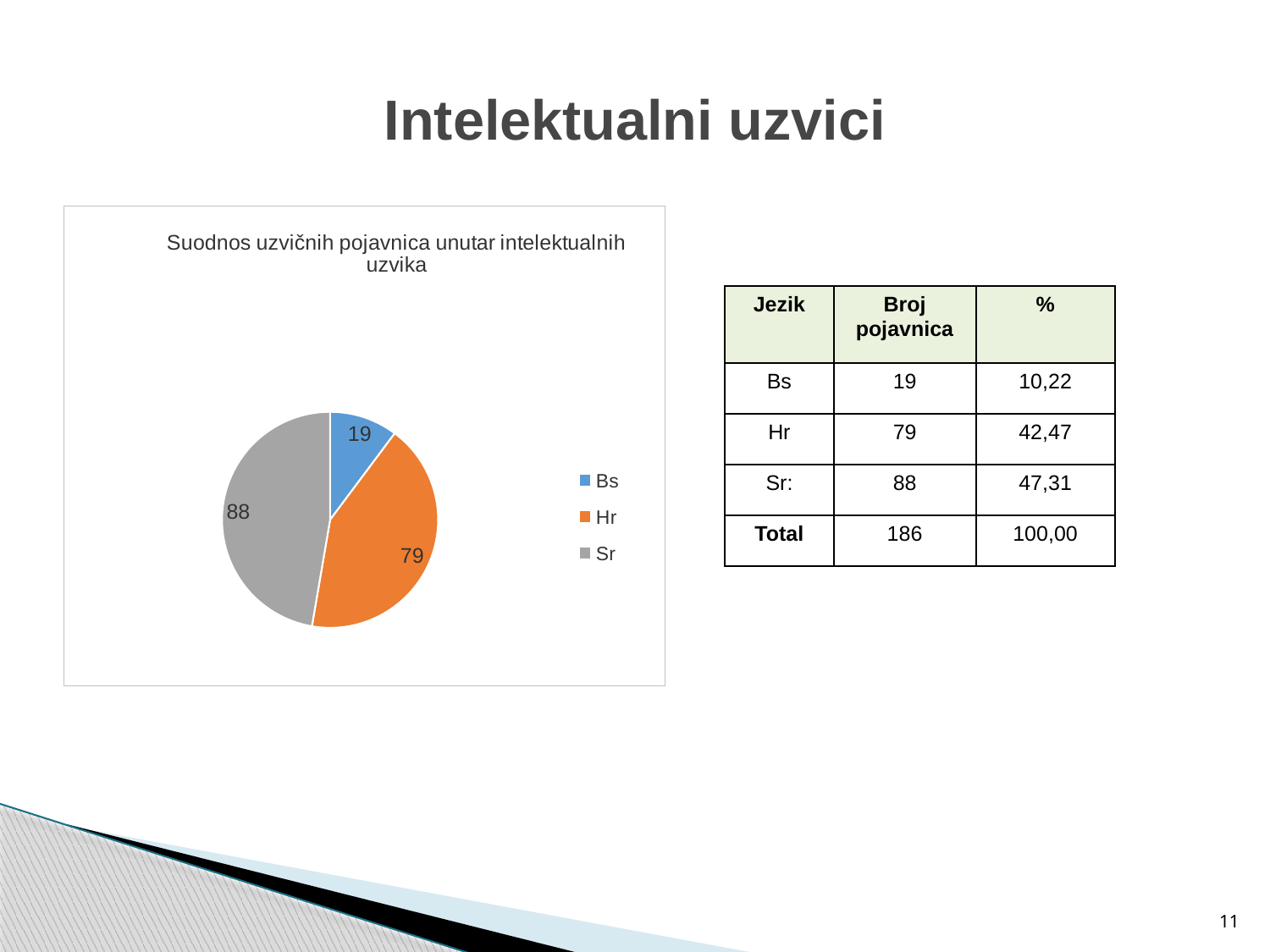
How many slices does the pie chart have? 3 What is the difference between the values for Sr and Hr in the pie chart? 9 What is the value for Hr in the pie chart? 79 Which category has the smallest slice in the pie chart? Bs Which is larger in the pie chart, the value for Hr or the value for Bs? Hr What is the value for Sr in the pie chart? 88 What type of chart is shown on the slide? pie chart What is the title of the pie chart? Suodnos uzvičnih pojavnica unutar intelektualnih uzvika Which category has the largest slice in the pie chart? Sr How many entries does the legend of the pie chart list? 3 What colour is the Hr slice in the pie chart? orange What is the value for Bs in the pie chart? 19